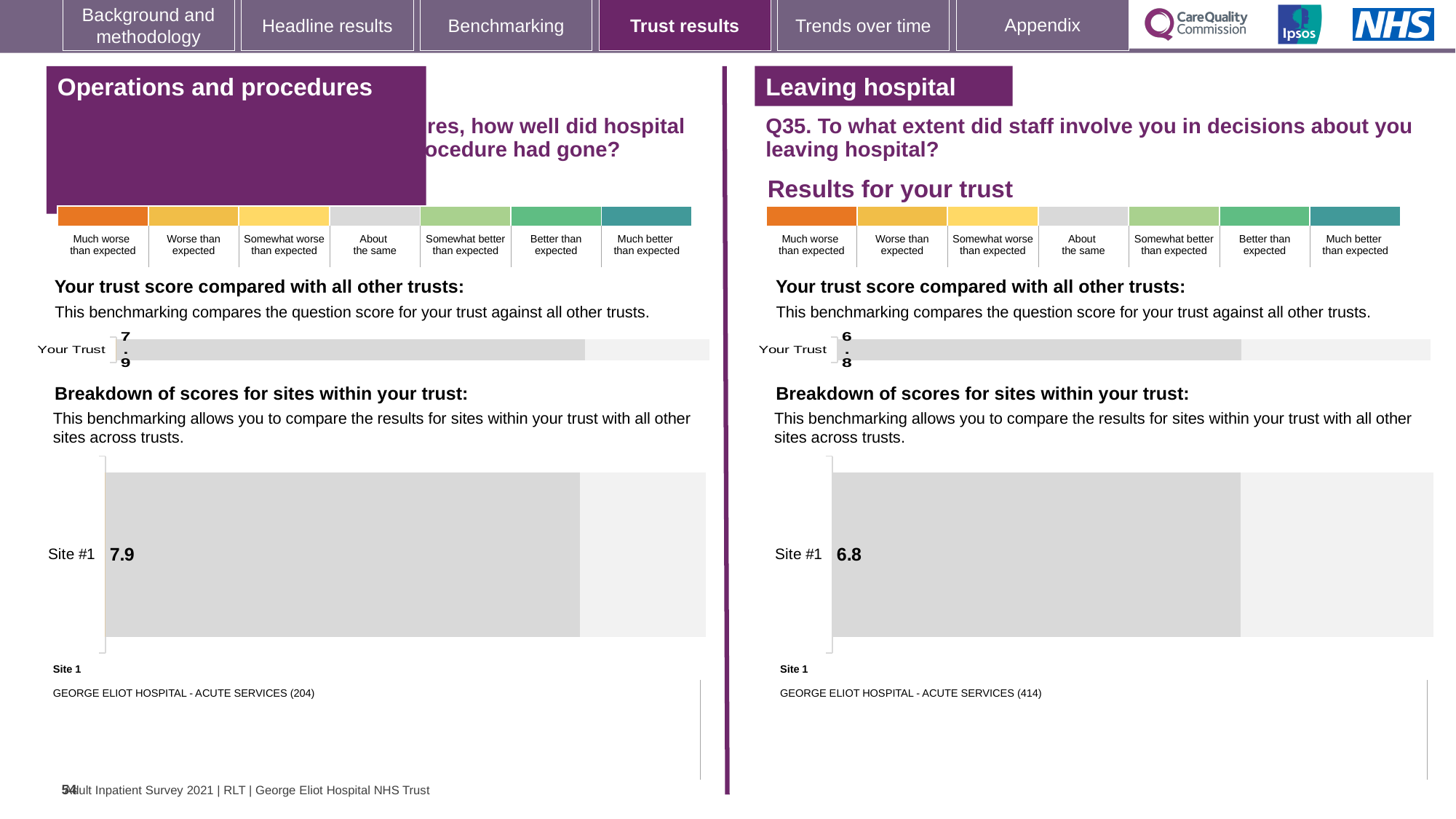
What type of chart is used to show the Site #1 score in the 'Leaving hospital' section? Bar chart Which site name is listed as Site 1 in the 'Operations and procedures' section? GEORGE ELIOT HOSPITAL - ACUTE SERVICES (204) How many sites are shown in the site breakdown chart in the 'Leaving hospital' section? 1 In the 'Leaving hospital' section, what score is shown for Site #1 in the site breakdown chart? 6.8 Which section's Site #1 score is larger: 'Operations and procedures' or 'Leaving hospital'? Operations and procedures In the 'Operations and procedures' section, what is the score shown for Your Trust in the trust comparison chart? 7.9 Which site name is listed as Site 1 in the 'Leaving hospital' section? GEORGE ELIOT HOSPITAL - ACUTE SERVICES (414) What is the difference between the Site #1 score in the 'Operations and procedures' section and the Site #1 score in the 'Leaving hospital' section? 1.1 How many sites are shown in the site breakdown chart in the 'Operations and procedures' section? 1 In the 'Leaving hospital' section, what is the score shown for Your Trust in the trust comparison chart? 6.8 Is the Your Trust score in the 'Leaving hospital' section greater or less than the Your Trust score in the 'Operations and procedures' section? less In the 'Operations and procedures' section, what score is shown for Site #1 in the site breakdown chart? 7.9